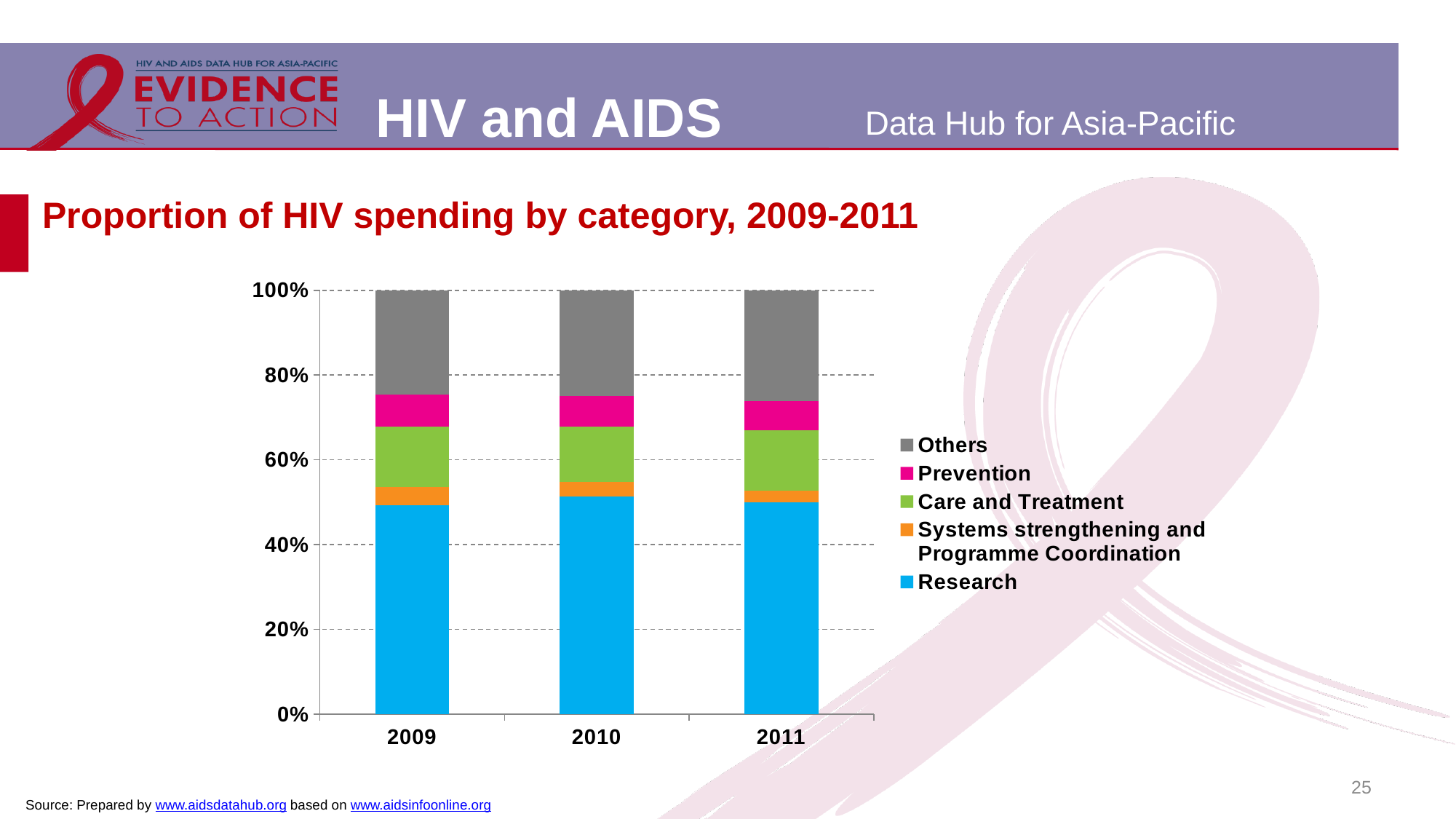
In 2009, which is larger: the share for Research or the share for Others? Research What kind of chart is shown on the slide? Stacked bar chart Which series is shown in blue in the chart? Research How many series does the chart's legend list? 5 What is the total of the stacked bar for 2011? 100% Is the share for Others in 2009 greater or less than 20%? greater In 2010, which is larger: the share for Care and Treatment or the share for Prevention? Care and Treatment Is the share for Research in 2010 greater or less than 40%? greater Which spending category takes the largest share of the 2009 bar? Research How many years are shown on the x axis of the chart? 3 Which spending category takes the smallest share of the 2011 bar? Systems strengthening and Programme Coordination What is the title of the chart? Proportion of HIV spending by category, 2009-2011